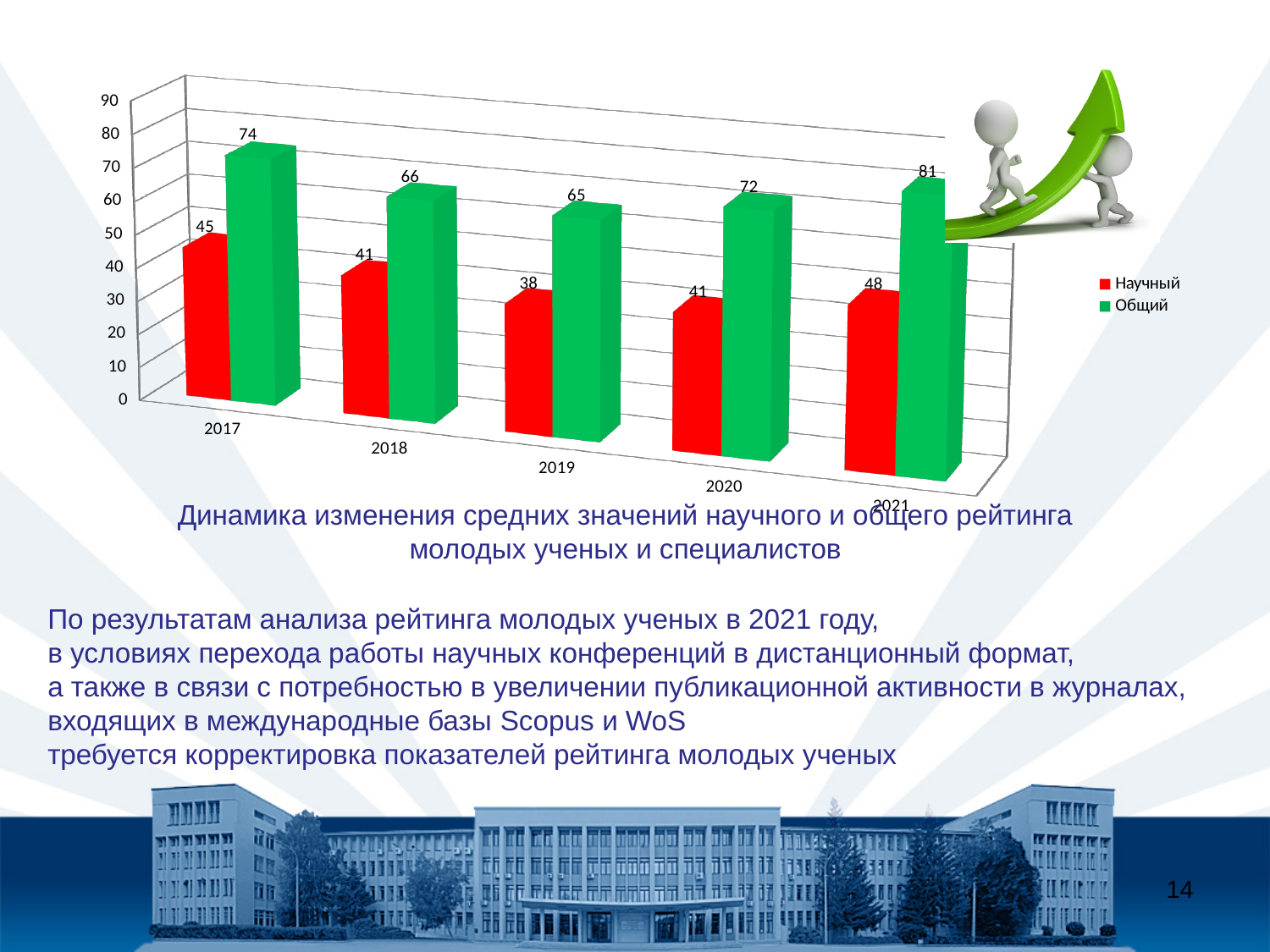
Does the Общий series rise or fall from 2019 to 2021? rise Which colour represents the Научный series? red What is the value of Общий for 2017? 74 What kind of chart is shown on the slide? bar chart In which year is the Научный series lowest? 2019 How many years are shown on the x axis? 5 In which year is the Общий series highest? 2021 Which is larger: Научный in 2017 or Научный in 2021? Научный in 2021 What is the difference between Общий and Научный in 2020? 31 How many series does the legend list? 2 What is the value of Научный for 2019? 38 What is the value of Общий for 2021? 81